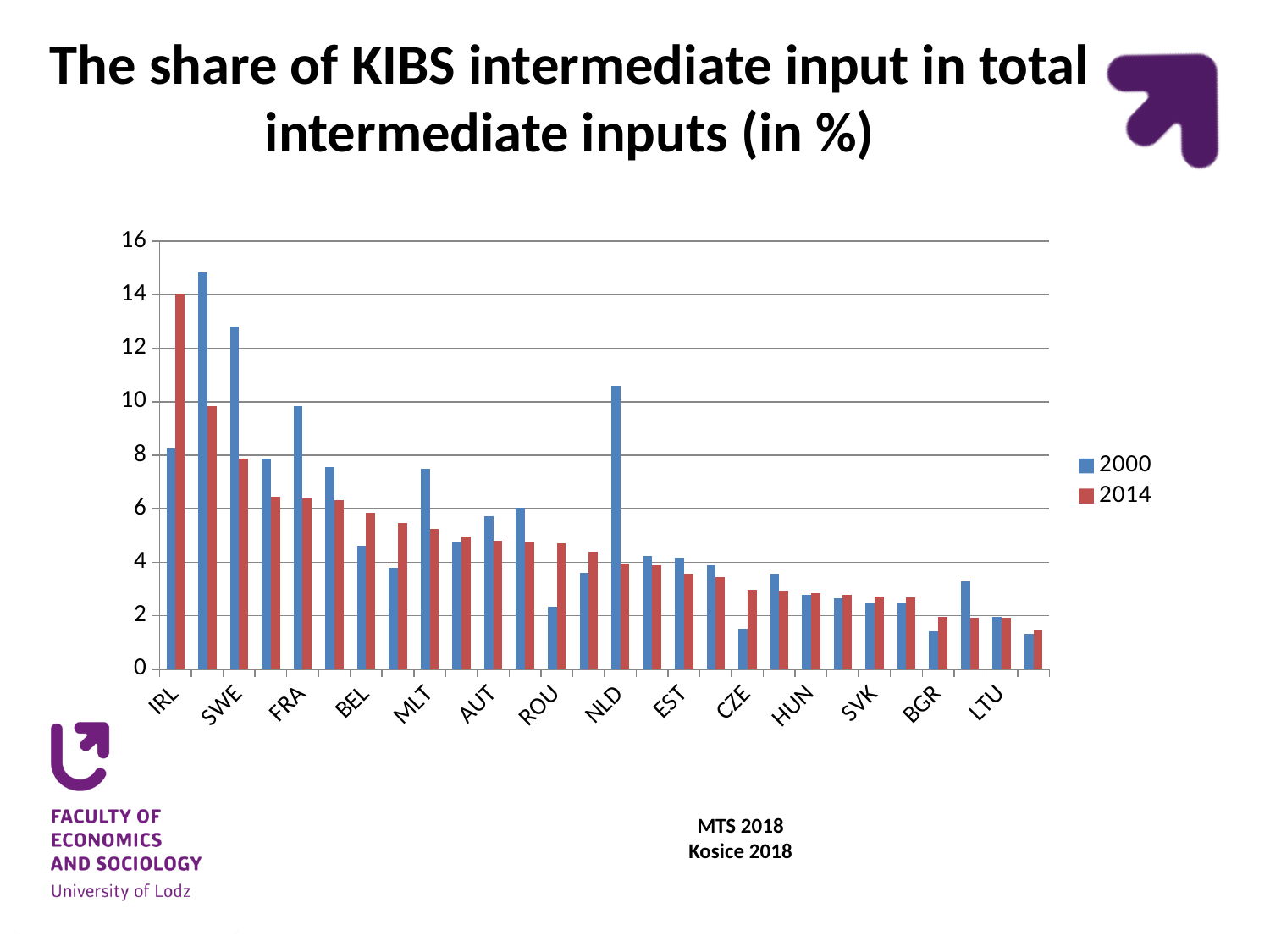
Is the 2000 value for FRA greater or less than 8? greater For IRL, which year has the larger value, 2000 or 2014? 2014 What kind of chart is shown on the slide? bar chart Is the 2000 value for NLD greater or less than 8? greater For NLD, which year has the larger value, 2000 or 2014? 2000 How many series does the legend list? 2 Is the 2014 value for IRL greater or less than 12? greater Which two years are listed in the legend? 2000 and 2014 Do the 2014 values generally rise or fall from left to right across the countries? fall Which country has the highest 2014 value? IRL